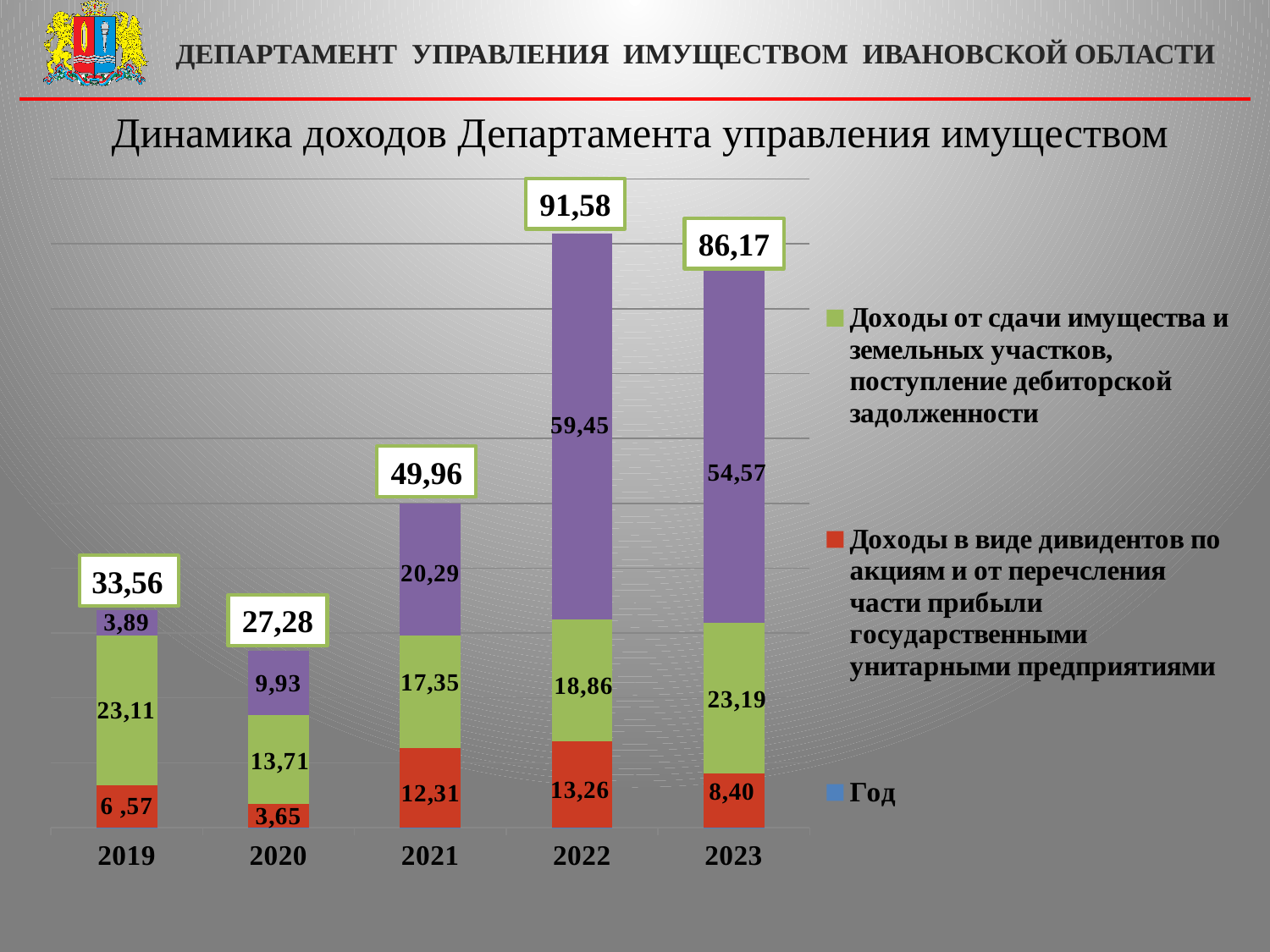
What kind of chart is shown on the slide? Stacked bar chart What is the total shown above the stacked bar for 2022? 91,58 What is the total shown above the stacked bar for 2019? 33,56 What is the value of the red segment (Доходы в виде дивидентов по акциям) for 2022? 13,26 How many years are shown on the x axis? 5 What is the difference between the totals for 2022 and 2023? 5,41 Which year has the larger green segment value, 2019 or 2023? 2023 Which year has the lowest total? 2020 Which year has the highest total? 2022 What is the difference between the red segment values for 2021 and 2020? 8,66 Do the totals rise or fall from 2020 to 2022? Rise What is the value of the green segment (Доходы от сдачи имущества и земельных участков) for 2021? 17,35